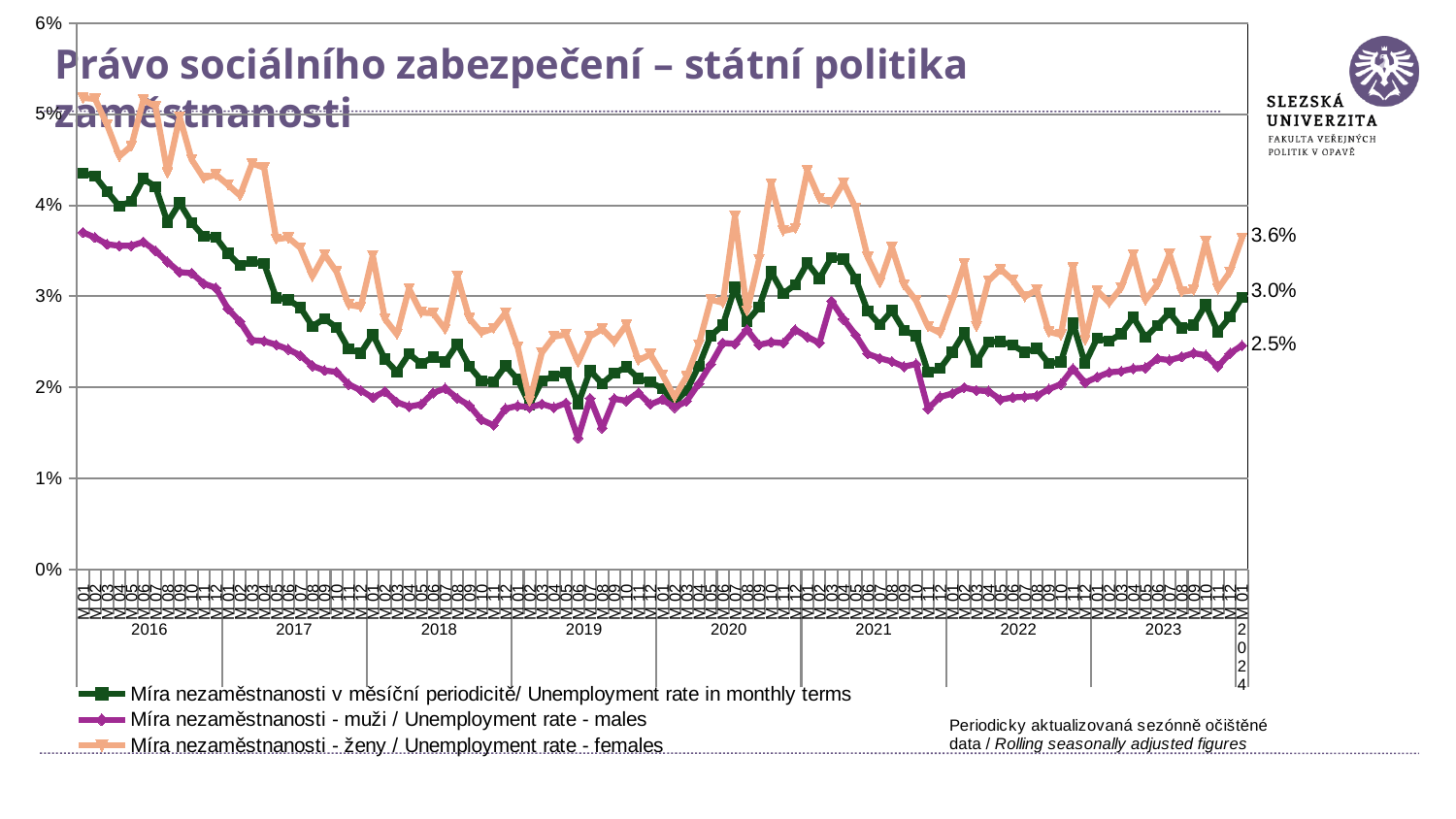
Does the overall unemployment rate rise or fall from 2016 to 2019? fall What is the last labelled value for the males series (Unemployment rate - males)? 2.5% At the end of the series, which is larger: the unemployment rate for females or for males? females How many year labels are shown on the x axis? 9 What kind of chart is shown on the slide? line chart What is the last labelled value for the overall series (Unemployment rate in monthly terms)? 3.0% Which series has the highest values across the whole chart? Unemployment rate - females Which series has the lowest values across the whole chart? Unemployment rate - males How many series does the legend list? 3 What is the difference between the last labelled values for females (3.6%) and males (2.5%)? 1.1% What is the last labelled value for the females series (Unemployment rate - females)? 3.6% Is the value for females at the start of 2016 greater or less than 4%? greater